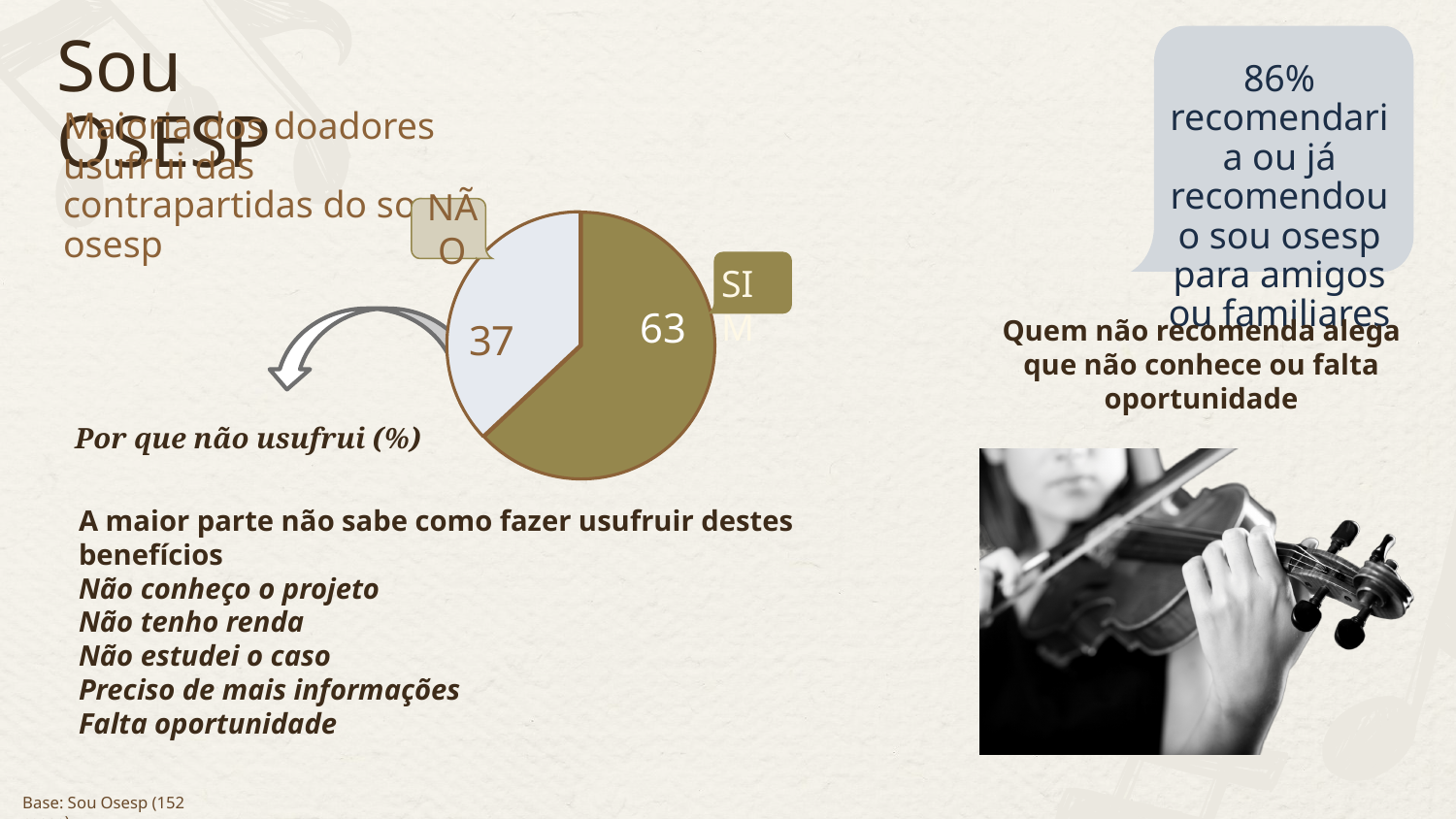
Is the value of the SIM slice greater or less than 50? greater What kind of chart is shown on the slide? pie chart How many slices does the pie chart have? 2 What share of the pie does the NÃO slice represent? 37% Which is larger in the pie chart, SIM or NÃO? SIM What is the total of the two slices in the pie chart? 100 What colour is the SIM slice in the pie chart? gold What is the value of the SIM slice in the pie chart? 63 Which slice of the pie chart is the largest? SIM What is the difference between the SIM and NÃO values in the pie chart? 26 Which slice of the pie chart is the smallest? NÃO What is the value of the NÃO slice in the pie chart? 37